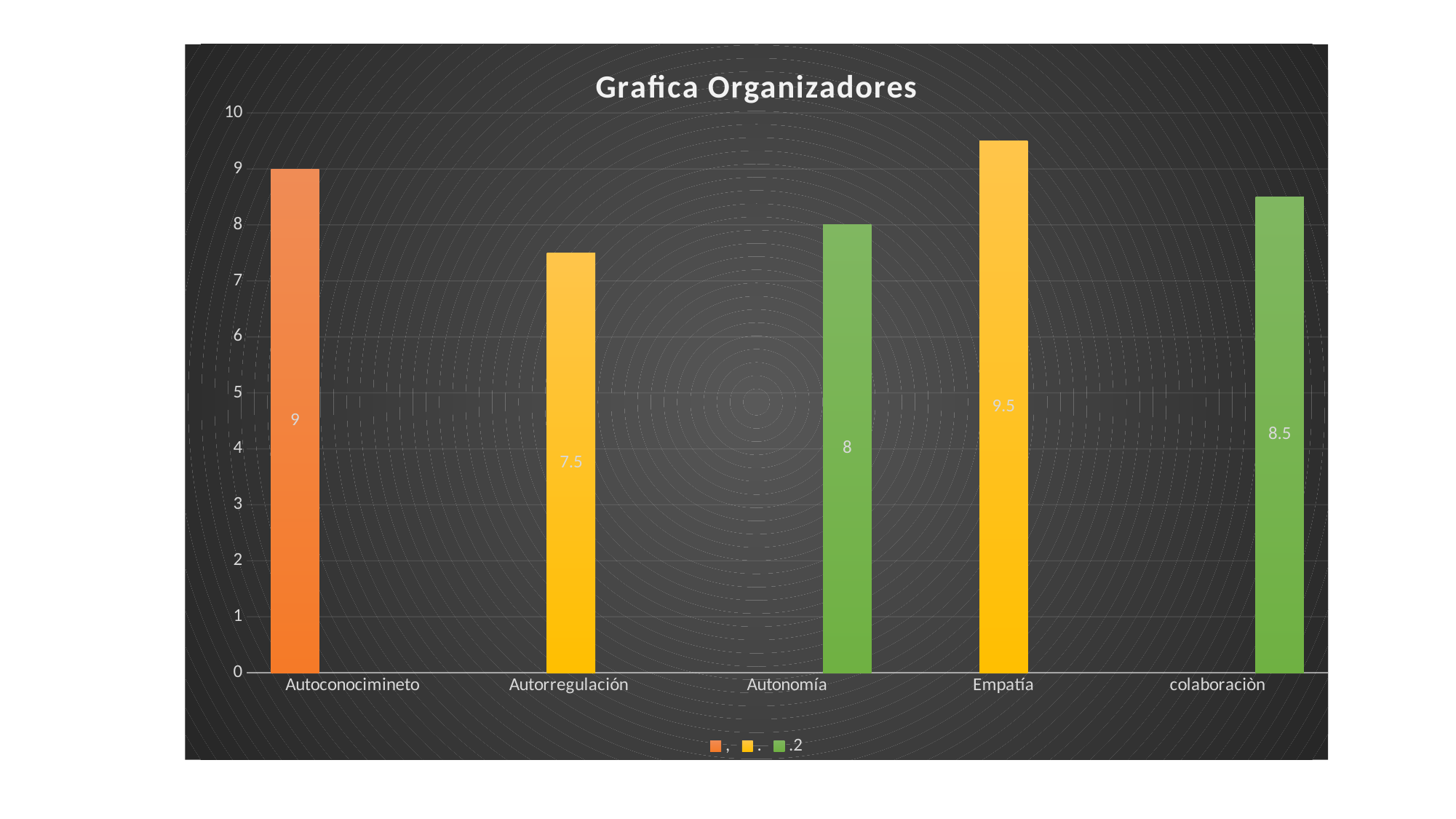
Is the value for Autonomía greater or less than 9? less Which category has the highest value? Empatía What is the value for Autorregulación? 7.5 What is the title of the chart? Grafica Organizadores What is the value for colaboraciòn? 8.5 What is the value for Autoconocimineto? 9 How many categories are shown on the x axis? 5 Which is larger, the value for Autonomía or the value for colaboraciòn? colaboraciòn What is the value for Empatía in the Grafica Organizadores chart? 9.5 What is the difference between the values for Empatía and Autorregulación? 2 What kind of chart is shown on the slide? Bar chart Which category has the lowest value? Autorregulación